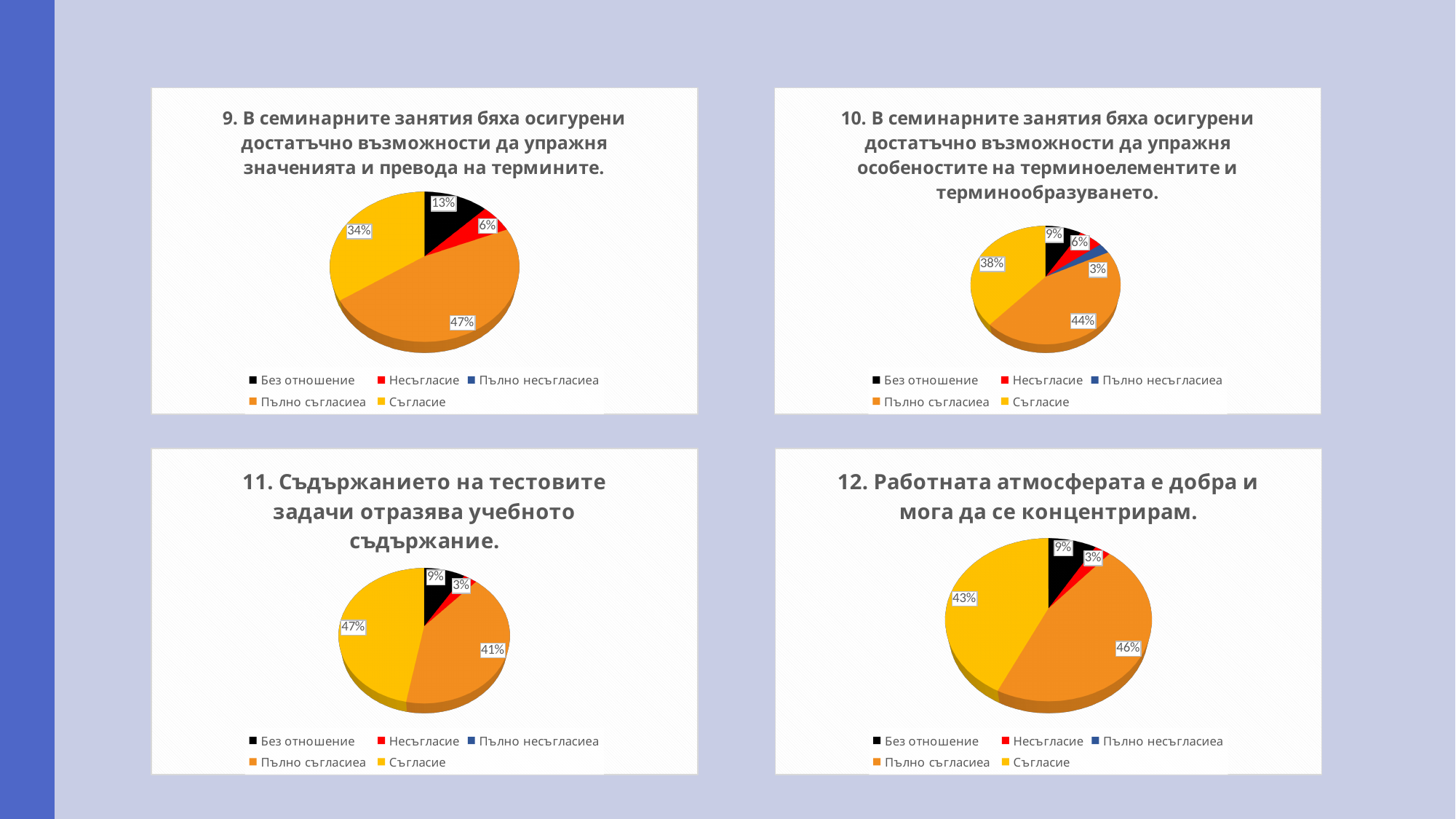
How many entries does the legend of the top-left chart (question 9) list? 5 In the top-right chart (question 10), which category has the smallest labelled slice? Пълно несъгласиеа In the top-right chart (question 10), what is the difference between the Пълно съгласиеа and Съгласие shares? 6% In the top-left chart (question 9), which category has the largest slice? Пълно съгласиеа In the bottom-left chart (question 11), what percentage is shown for Съгласие? 47% In the bottom-right chart (question 12), what is the difference between the Без отношение and Несъгласие shares? 6% What type of chart is used in the bottom-right chart (question 12)? Pie chart In the top-right chart (question 10), what percentage is shown for Пълно несъгласиеа? 3% In the bottom-left chart (question 11), which is larger: Съгласие or Пълно съгласиеа? Съгласие In the top-left chart (question 9), what share is labelled for the Пълно съгласиеа slice? 47% In the top-left chart (question 9), what percentage is shown for Без отношение? 13% In the bottom-right chart (question 12), what percentage is shown for Пълно съгласиеа? 46%